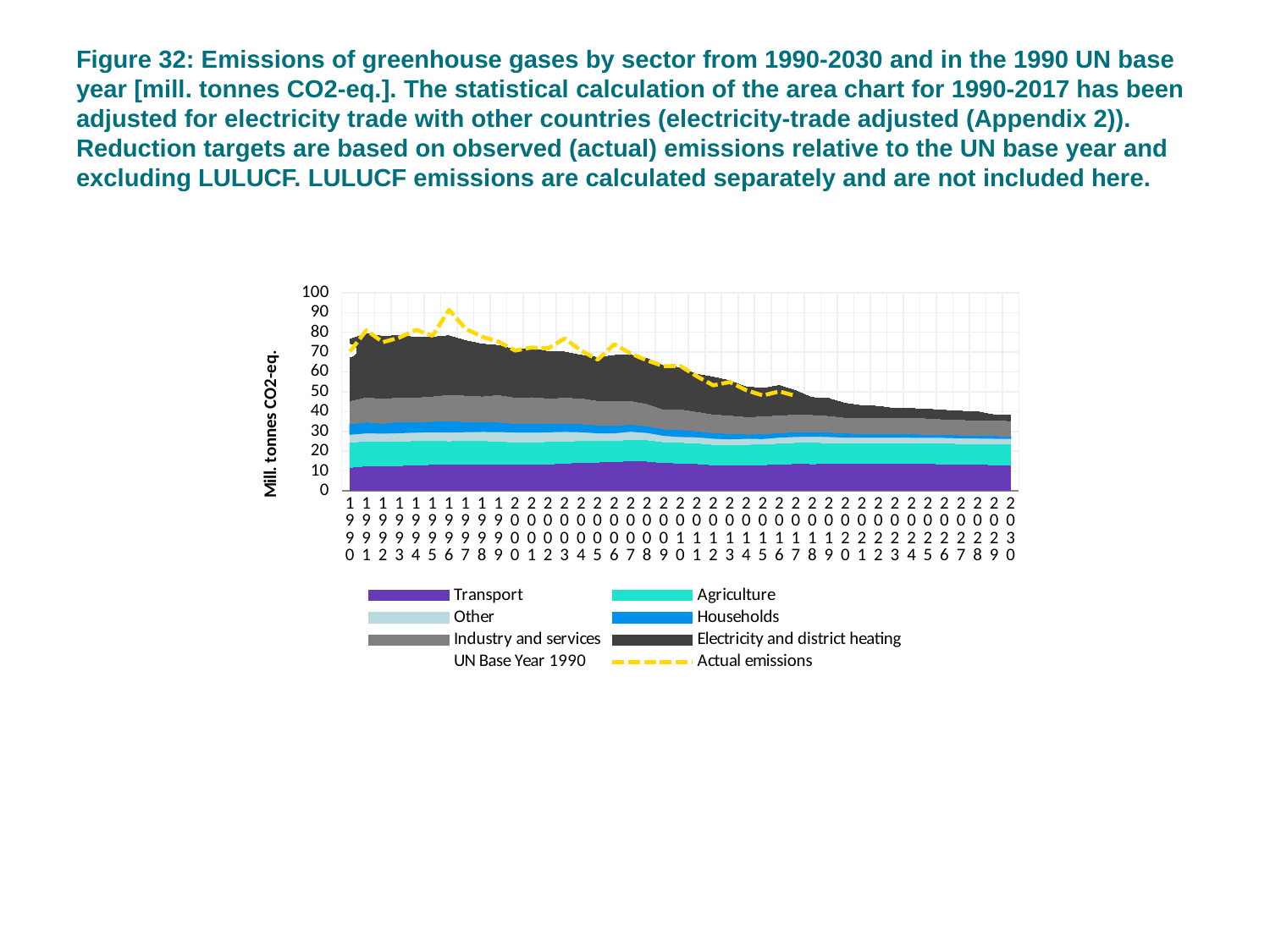
Is the Actual emissions value in 1996 greater or less than 80? greater In which year does the Actual emissions line reach its highest value? 1996 Is the Actual emissions value in 2017 greater or less than 60? less Which series is drawn as a yellow dashed line? Actual emissions How many series does the legend list? 8 Do the total stacked emissions rise or fall from 1990 to 2030? fall How many years are shown along the x axis? 41 What kind of chart is shown on the slide? area chart Is the total stacked emissions value in 2030 greater or less than 40? less What is the title of the y axis? Mill. tonnes CO2-eq. Which is larger, the total stacked emissions in 1990 or in 2030? 1990